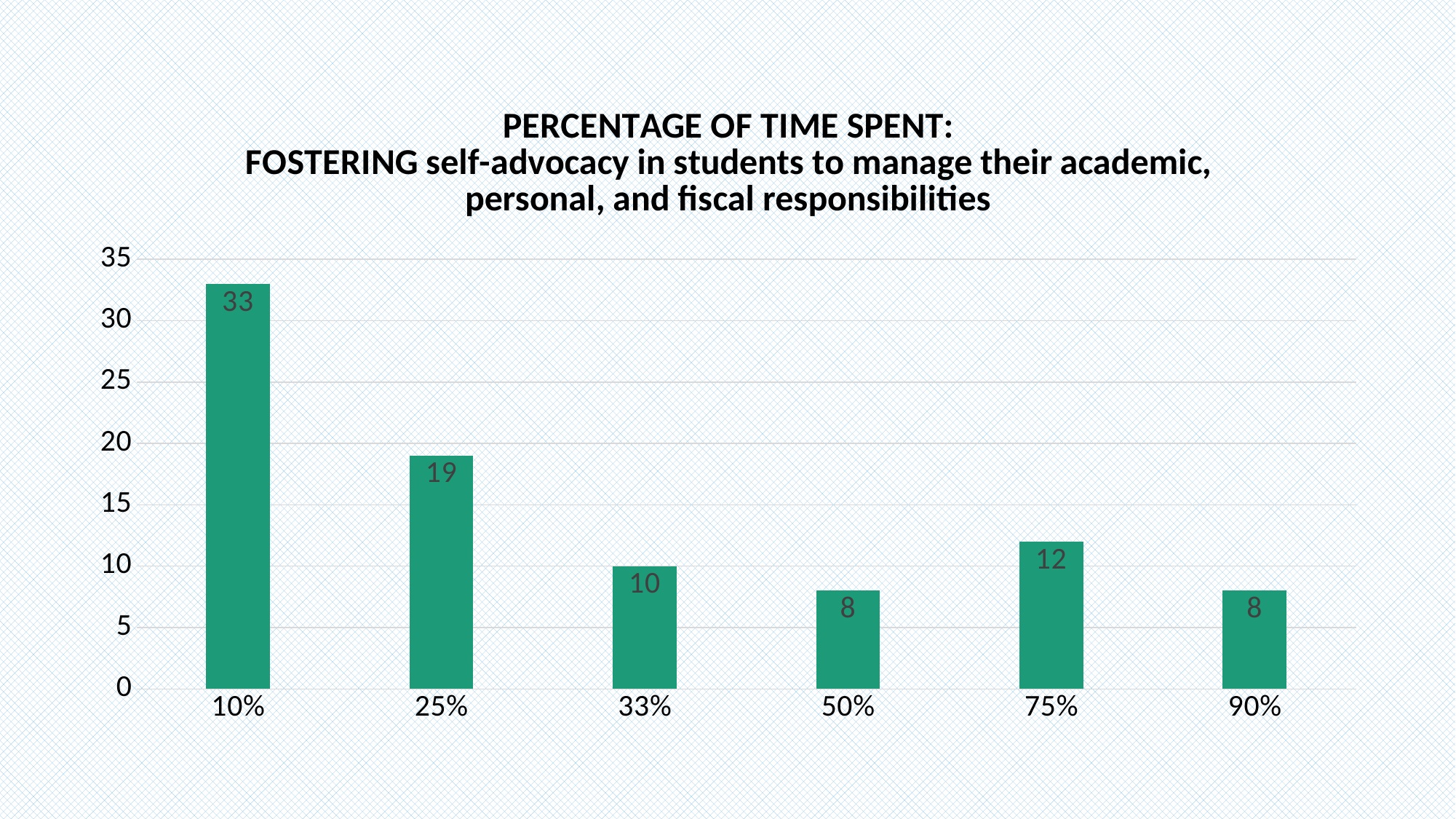
Is the value for 25% greater or less than 20? less What is the value for the 75% category? 12 What is the highest value shown on the y axis? 35 Which two categories share the lowest value? 50% and 90% What kind of chart is shown on the slide? bar chart Which category has the highest value? 10% What is the value for the 10% category? 33 What is the difference between the values for 75% and 33%? 2 Which is larger, the value for 33% or the value for 75%? 75% How many categories are shown on the x axis? 6 What is the value for the 25% category? 19 What is the difference between the values for 10% and 25%? 14